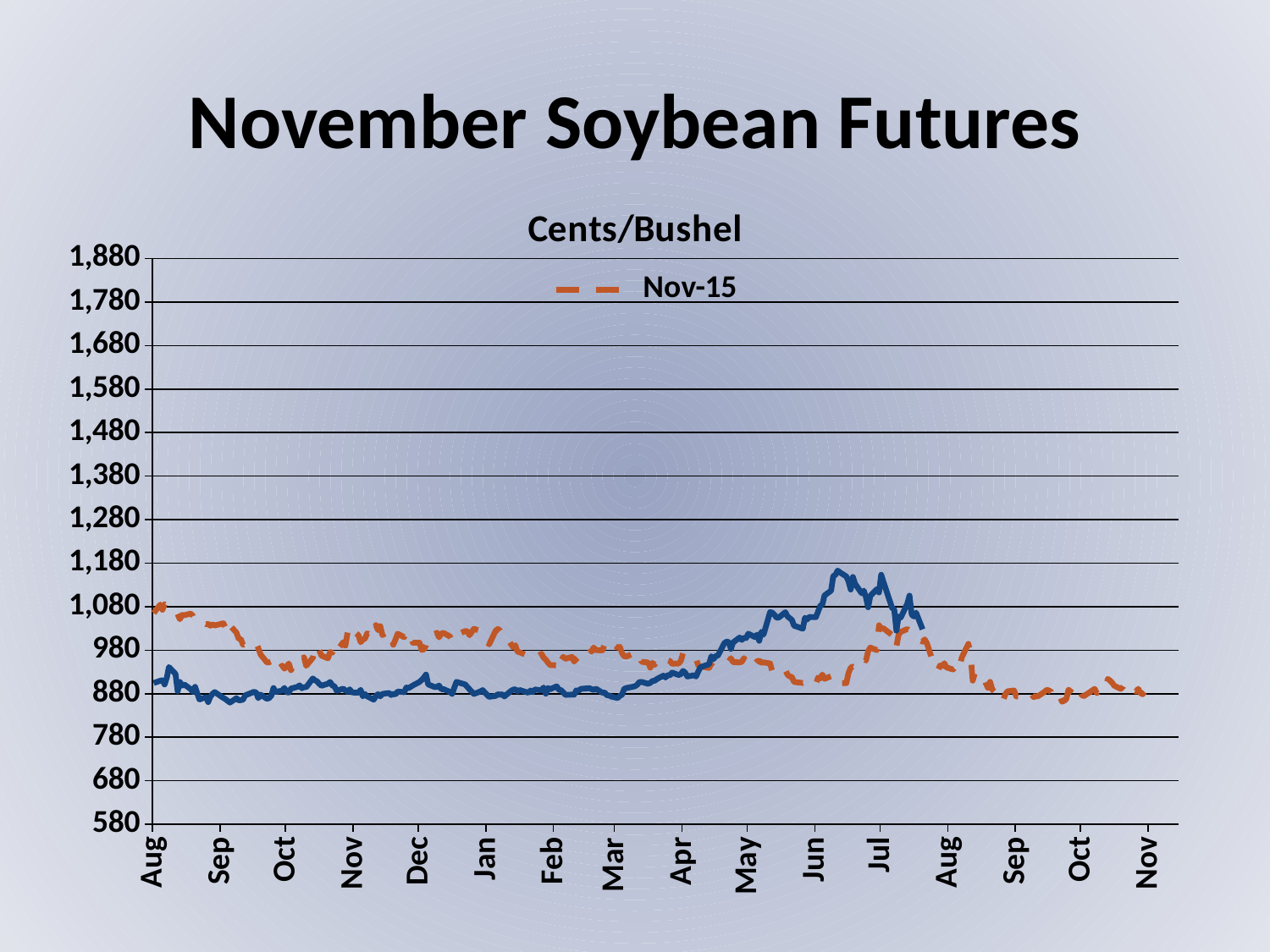
How many month labels are shown along the x axis? 16 What series name appears in the chart's legend? Nov-15 Is the peak value of the solid blue line around Jun greater or less than 1,080? greater Does the Nov-15 dashed line overall rise or fall from the first Aug to the final Nov? fall Is the value of the Nov-15 dashed line around Jun greater or less than 980? less How many series does the chart's legend list? 1 Is the value of the Nov-15 dashed line at the second Sep greater or less than 980? less Does the solid blue line rise or fall from Apr to Jun? rise What is the title shown above the chart's plot area? Cents/Bushel What kind of chart is shown on the slide? line chart What is the highest value shown on the y axis? 1,880